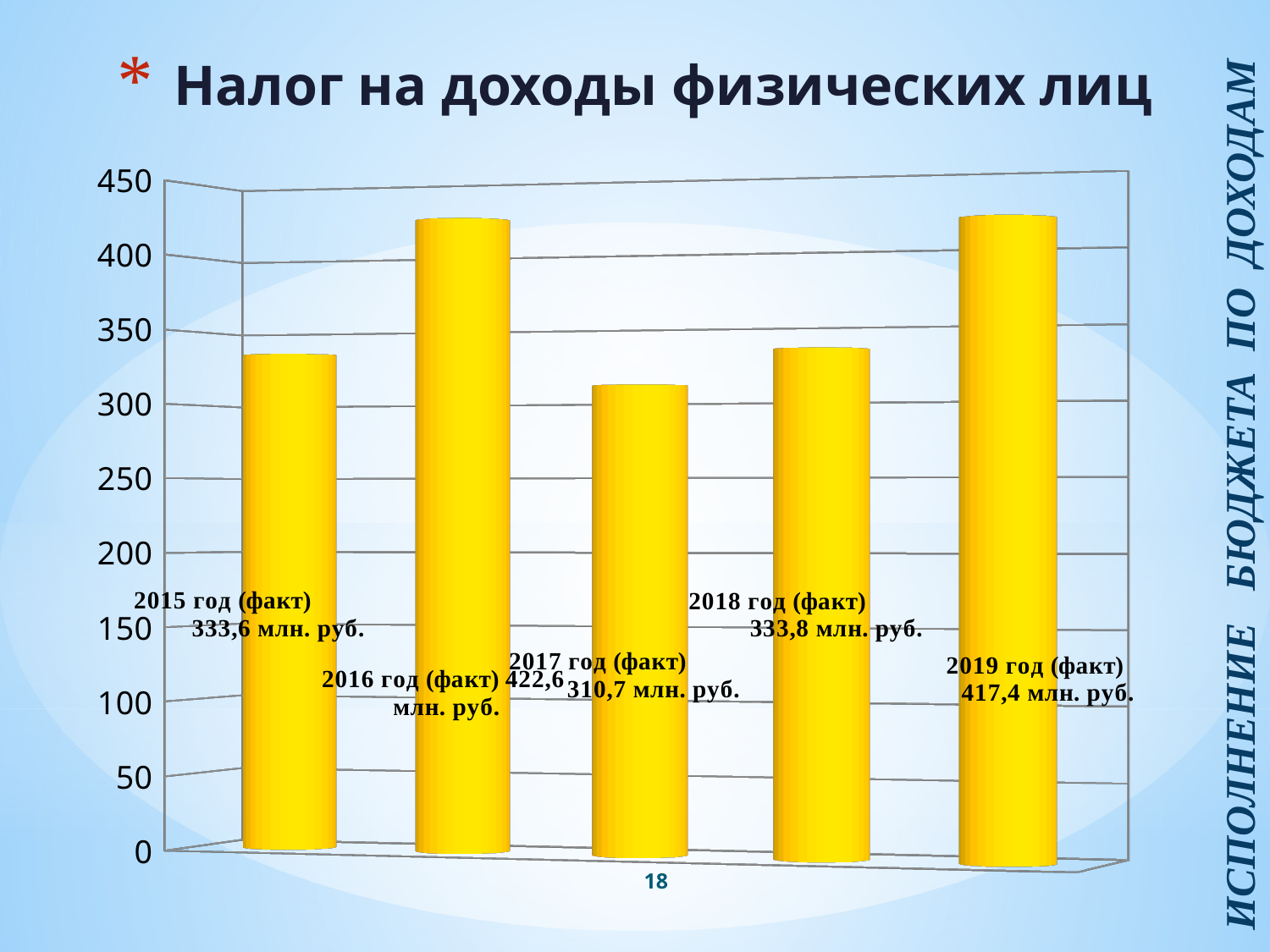
What is the value for 2019 год (факт)? 417,4 млн. руб. What is the title of the slide? Налог на доходы физических лиц Which year has the highest value? 2016 год (факт) What is the difference between the values for 2016 and 2017? 111,9 млн. руб. Which year has the lowest value? 2017 год (факт) What kind of chart is shown on the slide? bar chart Which is larger, the value for 2019 or the value for 2018? 2019 год (факт) How many bars are shown in the chart? 5 What is the value for 2015 год (факт)? 333,6 млн. руб. What is the value for 2016 год (факт)? 422,6 млн. руб. What is the value for 2017 год (факт)? 310,7 млн. руб. Is the value for 2017 greater or less than 350? less